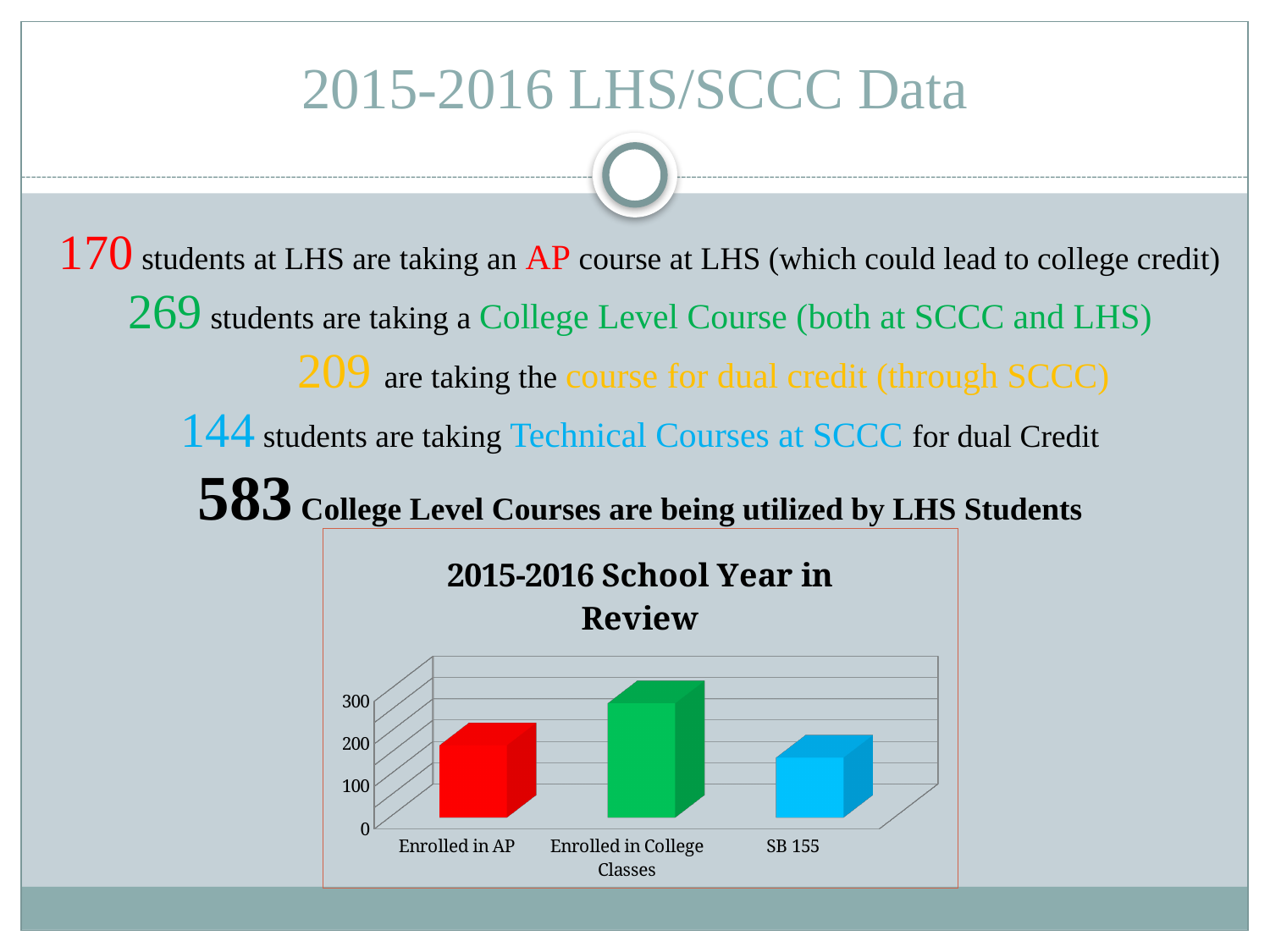
Which bar is taller, Enrolled in College Classes or Enrolled in AP? Enrolled in College Classes How many categories are plotted in the chart? 3 Which bar is taller, Enrolled in AP or SB 155? Enrolled in AP What colour is the bar for SB 155? blue Is the value for SB 155 greater or less than 200? less Is the value for Enrolled in College Classes greater or less than 200? greater What is the title of the chart? 2015-2016 School Year in Review What kind of chart is shown on the slide? bar chart Is the value for Enrolled in College Classes greater or less than 300? less Which category has the lowest bar in the chart? SB 155 Which category has the highest bar in the chart? Enrolled in College Classes